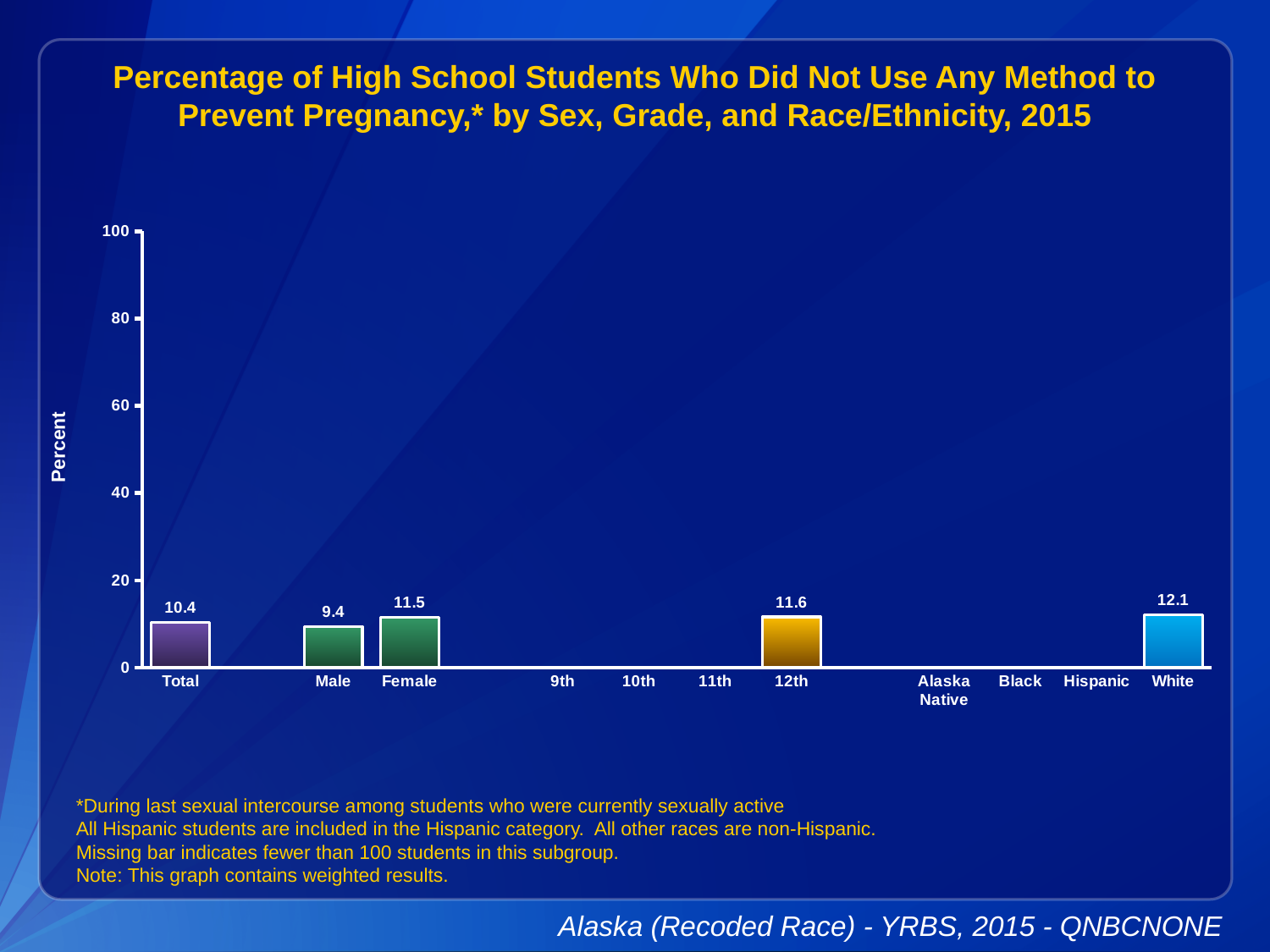
Which is larger, the value for White or the value for 12th grade? White What is the value for White? 12.1 Which category with a plotted bar has the lowest value? Male What is the difference between the Female and Male values? 2.1 What is the value for 12th grade? 11.6 How many categories have a bar plotted on the chart? 5 What is the value for Female? 11.5 What is the value for Male? 9.4 What kind of chart is shown on the slide? bar chart Is the value for Total greater or less than 20? less What is the value for Total? 10.4 Which category with a plotted bar has the highest value? White